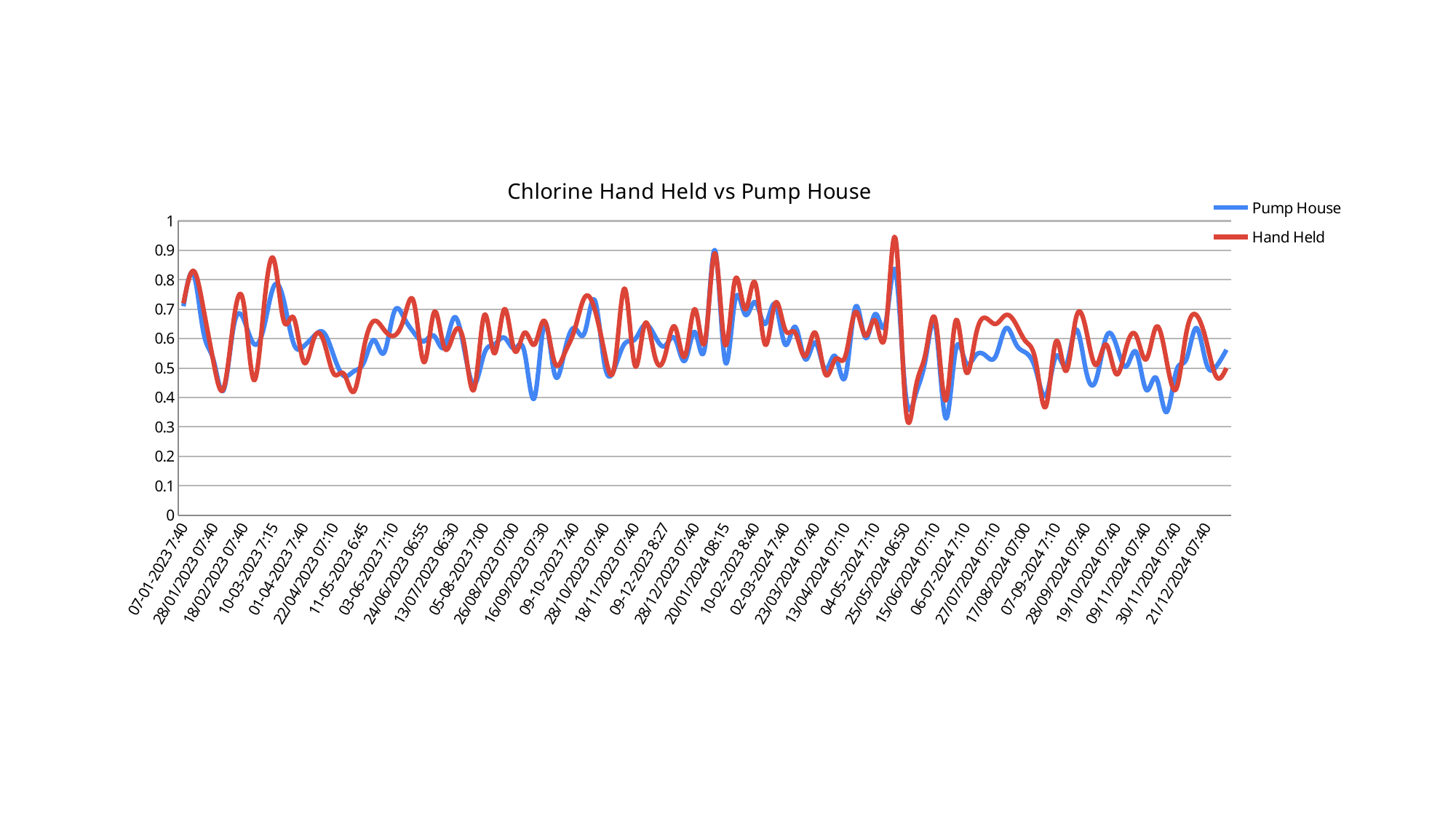
Is the Pump House value at 20/01/2024 08:15 greater or less than 0.8? less Is the Hand Held value at 25/05/2024 06:50 greater or less than 0.9? less Which series reaches the highest value anywhere on the chart, Pump House or Hand Held? Hand Held What kind of chart is shown on the slide? line chart Is the lowest Pump House value on the chart greater or less than 0.4? less What is the maximum value shown on the y axis? 1 How many series does the legend list? 2 What is the title of the chart? Chlorine Hand Held vs Pump House Which colour is used for the Hand Held series? red